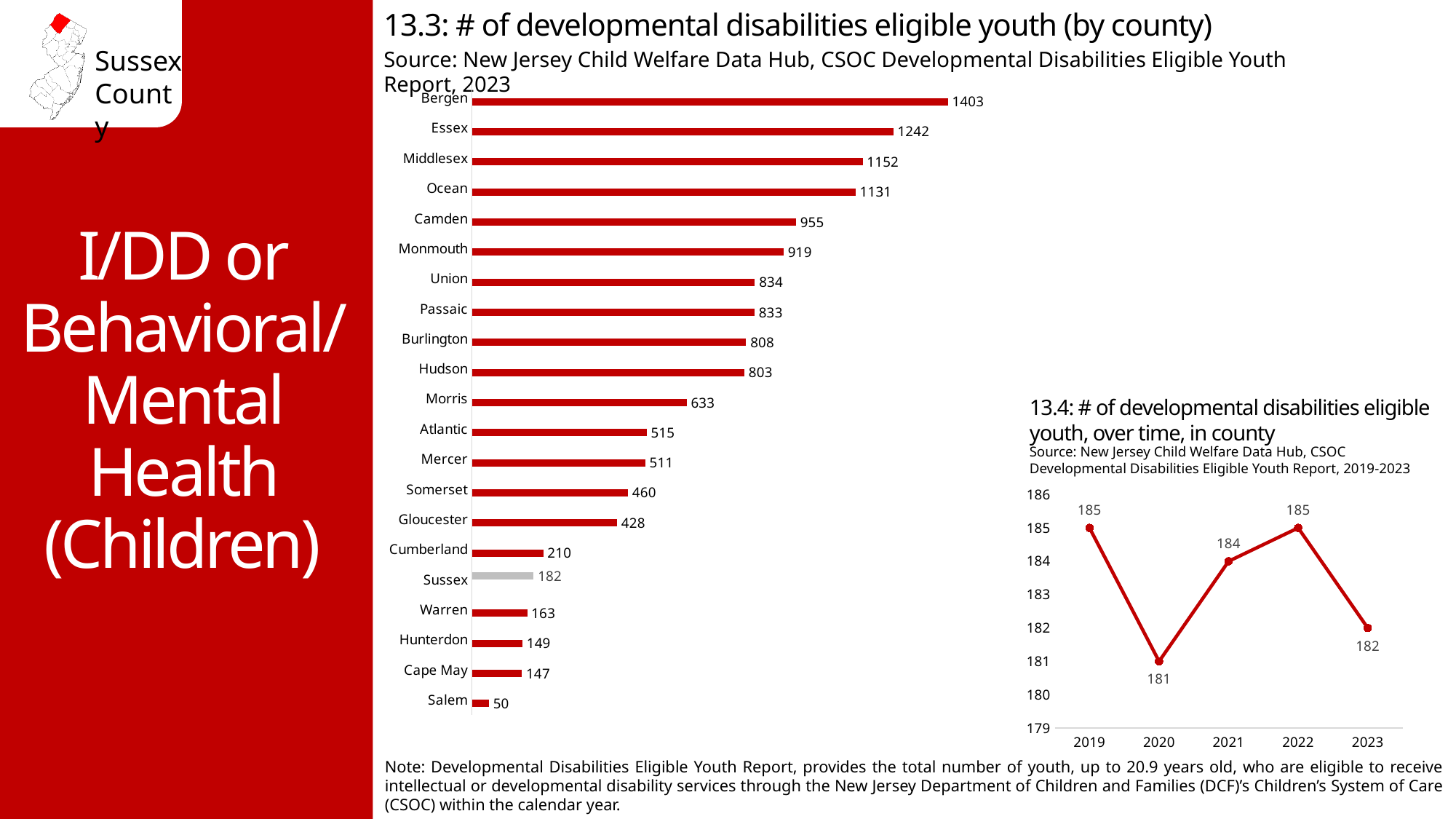
In chart 13.3 (# of developmental disabilities eligible youth by county), what is the value for Cape May? 147 In chart 13.3 (# of developmental disabilities eligible youth by county), what is the difference between Bergen and Essex? 161 In chart 13.3 (# of developmental disabilities eligible youth by county), how many counties are shown? 21 In chart 13.4 (# of developmental disabilities eligible youth over time in county), what is the difference between 2022 and 2023? 3 In chart 13.3 (# of developmental disabilities eligible youth by county), which county has the highest value? Bergen In chart 13.3 (# of developmental disabilities eligible youth by county), which county has the lowest value? Salem In chart 13.3 (# of developmental disabilities eligible youth by county), which is larger, Camden or Monmouth? Camden In chart 13.4 (# of developmental disabilities eligible youth over time in county), which year has the lowest value? 2020 In chart 13.3 (# of developmental disabilities eligible youth by county), what is the value for Sussex? 182 In chart 13.4 (# of developmental disabilities eligible youth over time in county), what is the value for 2020? 181 What kind of chart is chart 13.4 (# of developmental disabilities eligible youth over time in county)? Line chart What kind of chart is chart 13.3 (# of developmental disabilities eligible youth by county)? Bar chart